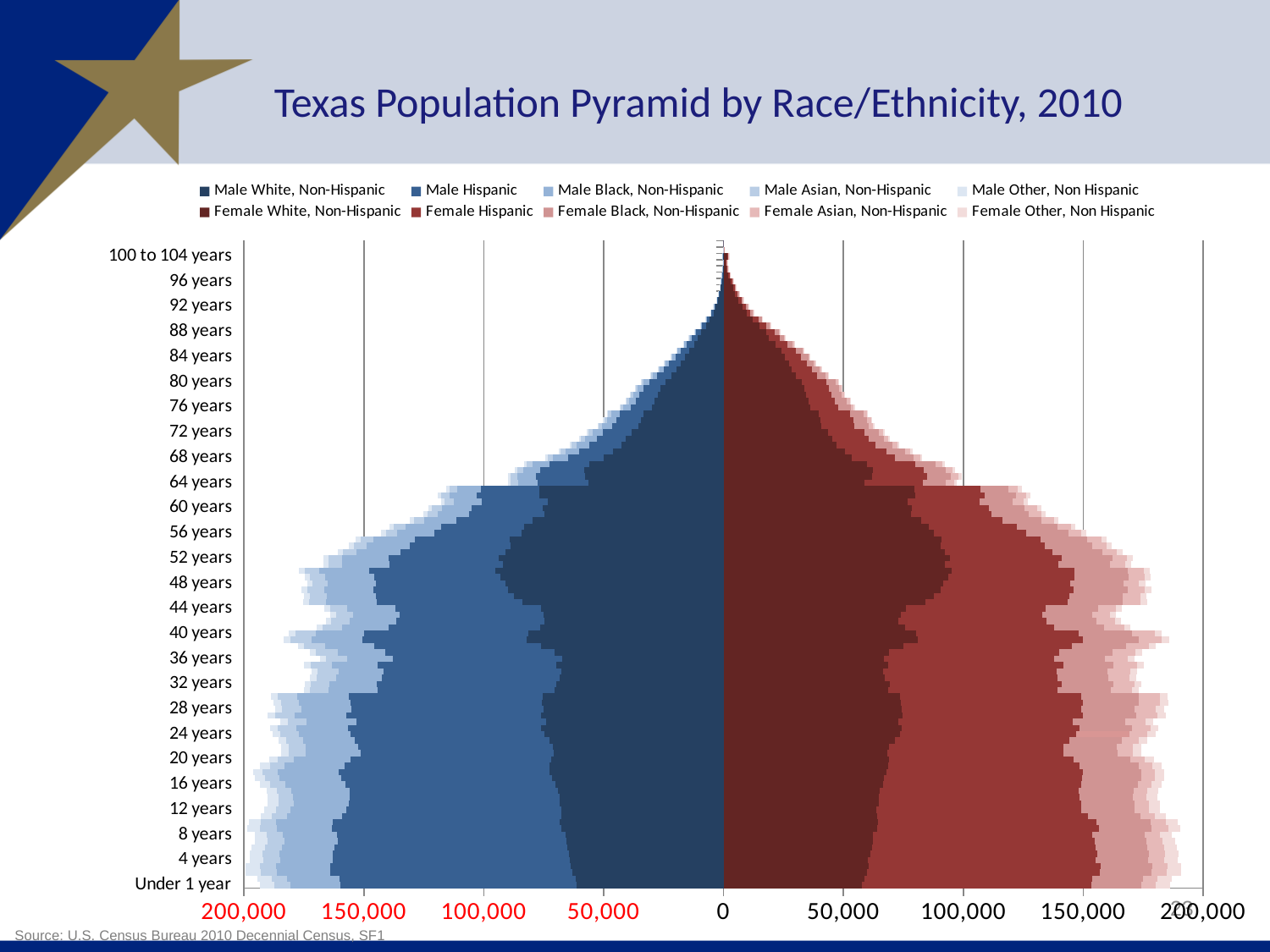
Is the total male population for 80 years greater or less than 50,000? less Is the total male population for Under 1 year greater or less than 150,000? greater Is the total female population for 40 years greater or less than 150,000? greater How many series does the legend list? 10 Which is larger, the total male population at Under 1 year or at 80 years? Under 1 year Which legend entry is shown in the darkest blue colour? Male White, Non-Hispanic What is the title of the chart? Texas Population Pyramid by Race/Ethnicity, 2010 Moving from 64 years up to 100 to 104 years, do the bar lengths rise or fall? fall What kind of chart is shown on the slide? Stacked bar chart (population pyramid)